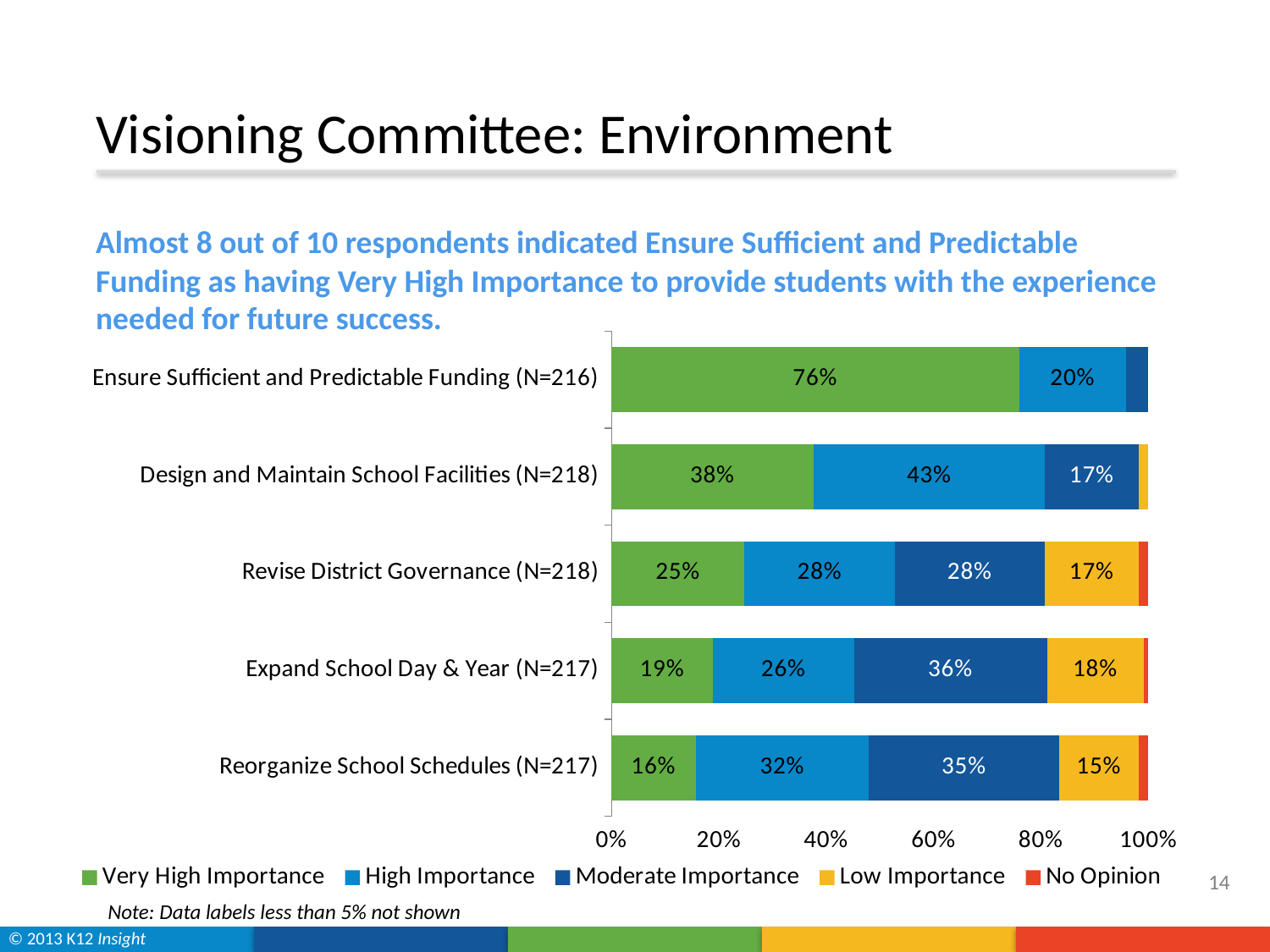
What percentage of respondents rated Ensure Sufficient and Predictable Funding as Very High Importance? 76% How many series does the legend list? 5 What is the Moderate Importance value for Expand School Day & Year? 36% What is the Low Importance value for Reorganize School Schedules? 15% What type of chart is shown on the slide? Stacked bar chart What is the High Importance value for Design and Maintain School Facilities? 43% How many categories are shown in the chart? 5 According to the note below the chart, which data labels are not shown? Data labels less than 5% Which category has the highest Very High Importance percentage? Ensure Sufficient and Predictable Funding How many percentage points higher is the Very High Importance value for Design and Maintain School Facilities than for Revise District Governance? 13 percentage points Which category has the lowest Very High Importance percentage? Reorganize School Schedules Which has a larger High Importance value: Design and Maintain School Facilities or Revise District Governance? Design and Maintain School Facilities